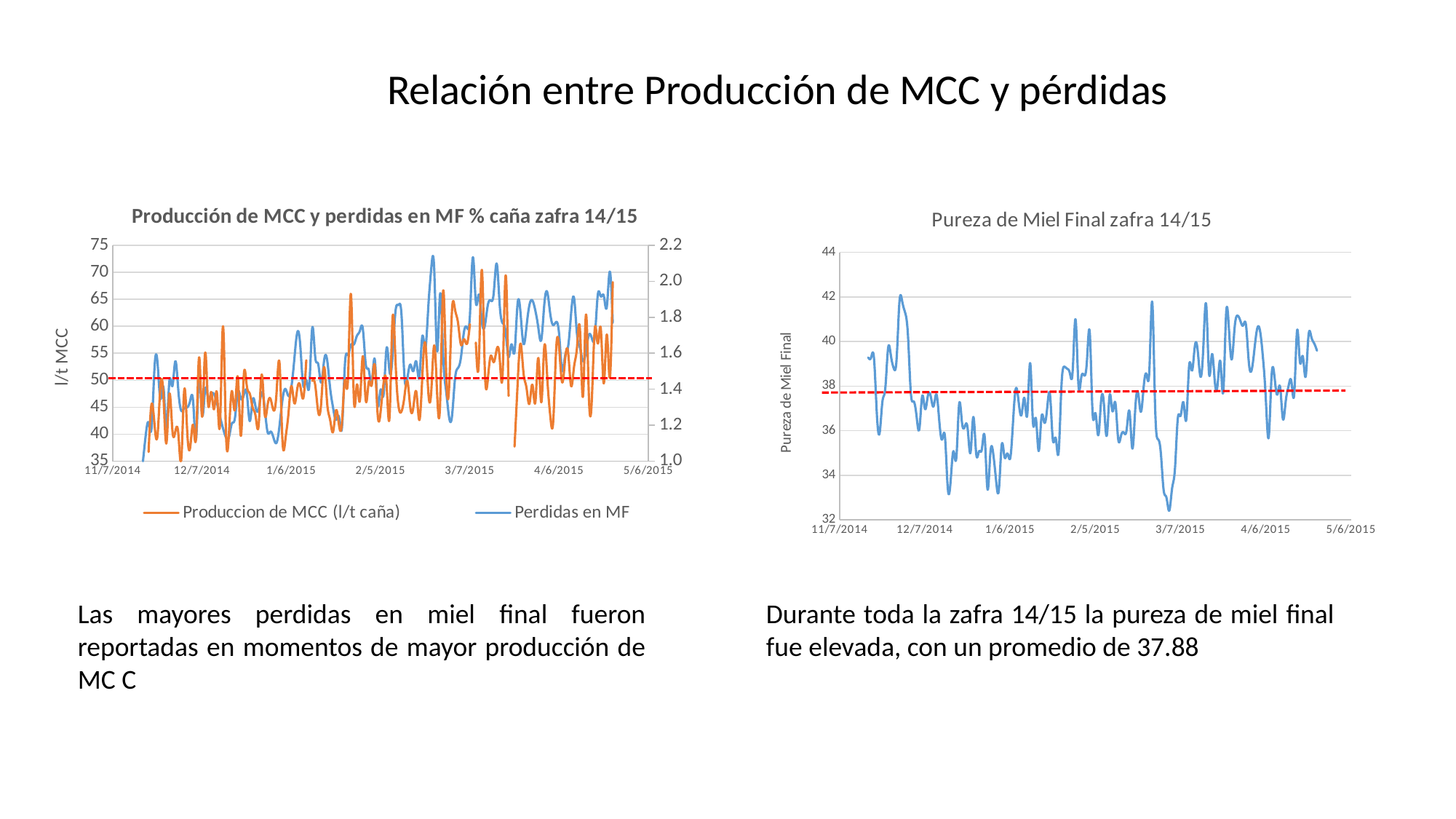
In the left chart (Producción de MCC y perdidas en MF % caña zafra 14/15), is the lowest Produccion de MCC value, shortly after 3/7/2015, greater or less than 40? less What kind of chart is the chart titled "Producción de MCC y perdidas en MF % caña zafra 14/15"? line chart What kind of chart is the chart titled "Pureza de Miel Final zafra 14/15"? line chart In the left chart (Producción de MCC y perdidas en MF % caña zafra 14/15), is the highest Perdidas en MF value, near 3/7/2015, greater or less than 2.0 on the right axis? greater What is the label of the vertical axis in the right chart (Pureza de Miel Final zafra 14/15)? Pureza de Miel Final In the left chart (Producción de MCC y perdidas en MF % caña zafra 14/15), which series is drawn in orange? Produccion de MCC (l/t caña) In the right chart (Pureza de Miel Final zafra 14/15), is the lowest value plotted near 3/7/2015 greater or less than 34? less In the left chart (Producción de MCC y perdidas en MF % caña zafra 14/15), do the Perdidas en MF values generally rise or fall from 11/7/2014 to 4/6/2015? rise How many series does the legend of the left chart (Producción de MCC y perdidas en MF % caña zafra 14/15) list? 2